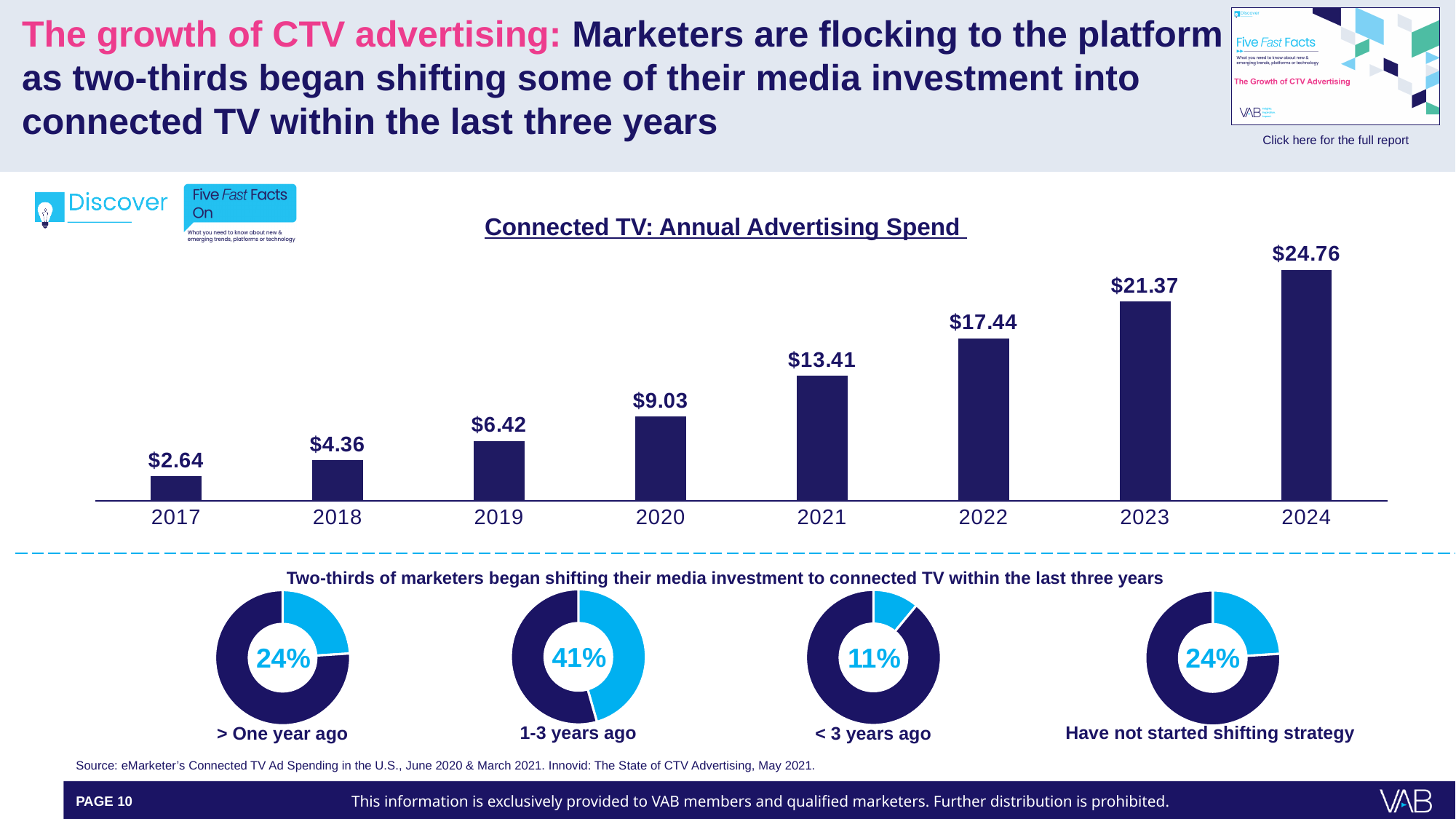
How many years are shown in the 'Connected TV: Annual Advertising Spend' chart? 8 In the 'Connected TV: Annual Advertising Spend' chart, what is the difference between the values for 2024 and 2023? $3.39 How many donut charts are shown at the bottom of the slide? 4 In the 'Connected TV: Annual Advertising Spend' chart, what is the value for 2020? $9.03 In the 'Connected TV: Annual Advertising Spend' chart, which year has the lowest value? 2017 What kind of chart is 'Connected TV: Annual Advertising Spend'? Bar chart In the 'Connected TV: Annual Advertising Spend' chart, which year has the highest value? 2024 In the 'Connected TV: Annual Advertising Spend' chart, do the values rise or fall from 2017 to 2024? Rise In the 'Connected TV: Annual Advertising Spend' chart, what is the value for 2017? $2.64 In the donut charts at the bottom of the slide, what percentage is shown for '1-3 years ago'? 41% In the 'Connected TV: Annual Advertising Spend' chart, which is larger, the value for 2021 or the value for 2019? 2021 In the donut charts at the bottom of the slide, what percentage is shown for '< 3 years ago'? 11%